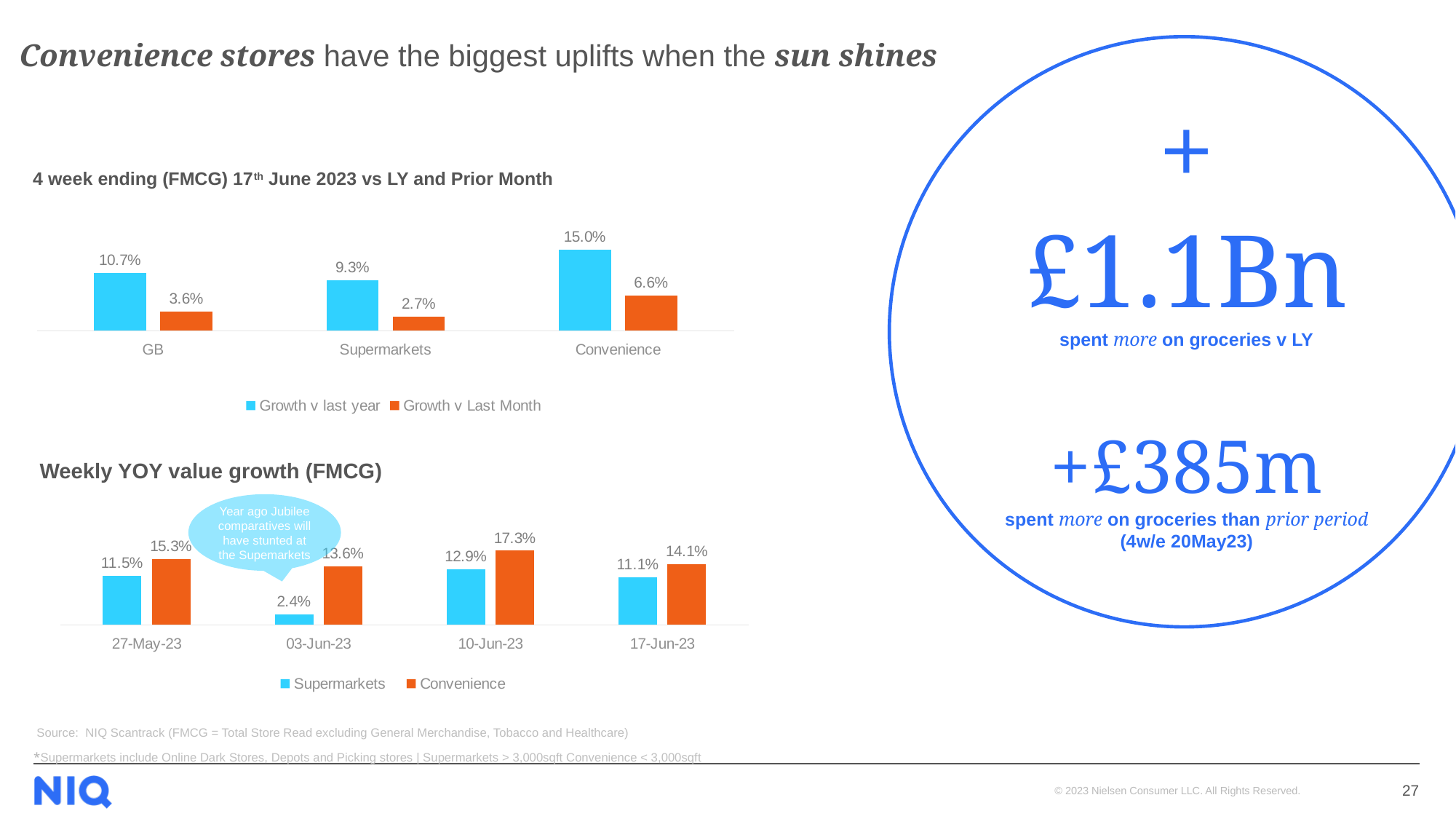
In the 'Weekly YOY value growth (FMCG)' chart, what is the Supermarkets value for 03-Jun-23? 2.4% In the '4 week ending (FMCG) 17th June 2023 vs LY and Prior Month' chart, what is the difference between Growth v last year and Growth v Last Month for GB? 7.1% What kind of chart is the 'Weekly YOY value growth (FMCG)' chart? Bar chart In the 'Weekly YOY value growth (FMCG)' chart, which week has the lowest Supermarkets value? 03-Jun-23 In the 'Weekly YOY value growth (FMCG)' chart, what is the difference between Convenience and Supermarkets for 17-Jun-23? 3.0% In the 'Weekly YOY value growth (FMCG)' chart, how many weeks are shown on the x axis? 4 In the '4 week ending (FMCG) 17th June 2023 vs LY and Prior Month' chart, which category has the highest Growth v last year? Convenience In the '4 week ending (FMCG) 17th June 2023 vs LY and Prior Month' chart, how many series does the legend list? 2 In the 'Weekly YOY value growth (FMCG)' chart, what is the Convenience value for 10-Jun-23? 17.3% In the '4 week ending (FMCG) 17th June 2023 vs LY and Prior Month' chart, what is the Growth v Last Month value for Supermarkets? 2.7% In the '4 week ending (FMCG) 17th June 2023 vs LY and Prior Month' chart, what is the Growth v last year value for Convenience? 15.0% In the 'Weekly YOY value growth (FMCG)' chart, which week has the highest Convenience value? 10-Jun-23